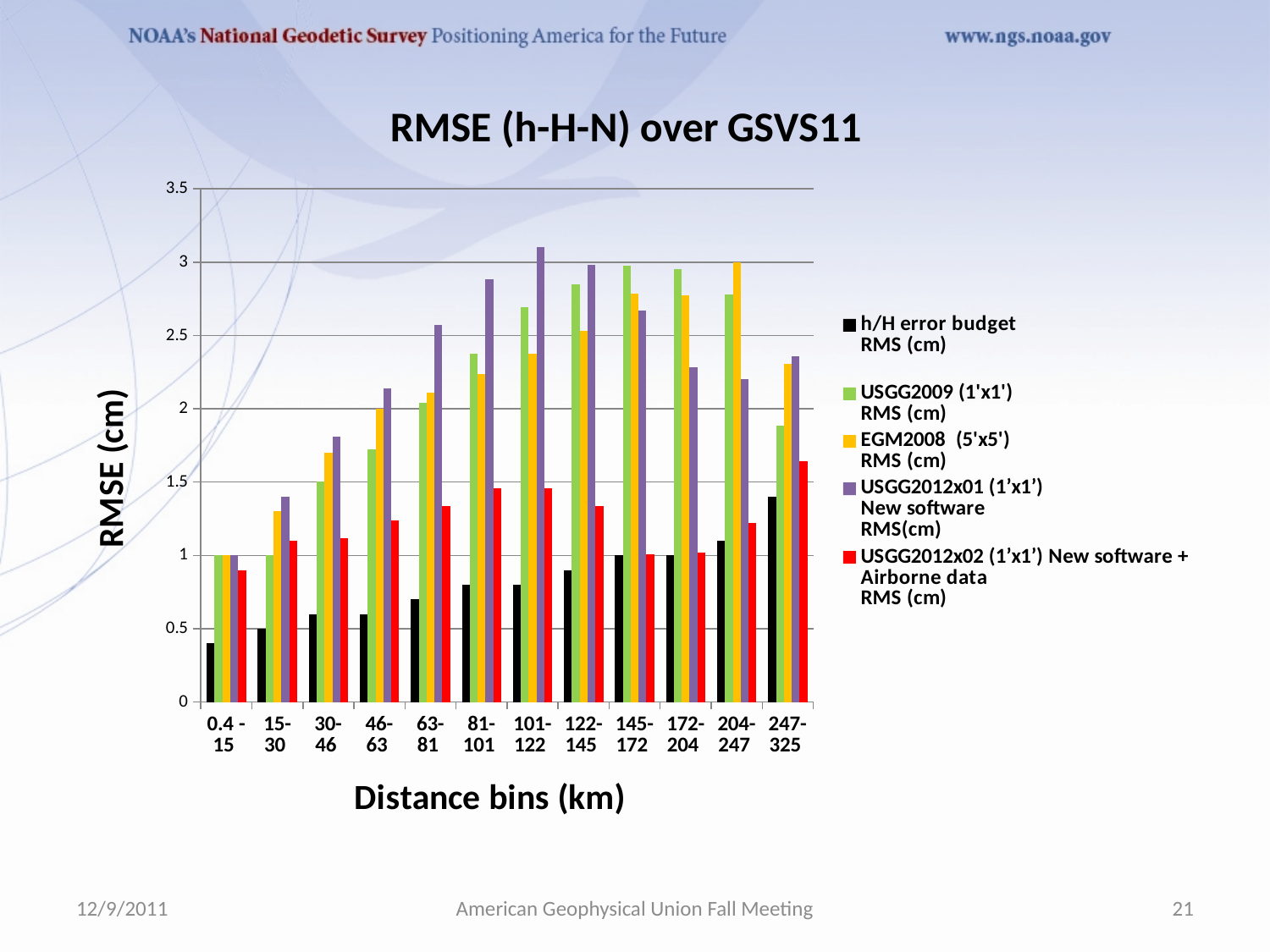
What is the title of the x axis? Distance bins (km) Is the value for USGG2012x01 in the 101-122 km bin greater or less than 2.5? greater Does the h/H error budget series rise or fall as the distance bins increase along the x axis? rise How many distance bins are shown on the x axis? 12 Which series has the highest value in the 101-122 km bin? USGG2012x01 (1'x1') New software RMS(cm) Is the value for h/H error budget in the 0.4-15 km bin greater or less than 0.5? less Which series has the lowest value in the 0.4-15 km bin? h/H error budget RMS (cm) What kind of chart is shown on the slide? bar chart In which distance bin is the h/H error budget highest? 247-325 Is the value for USGG2012x02 in the 247-325 km bin greater or less than 1.5? greater How many series does the legend list? 5 In the 204-247 km bin, which is larger: EGM2008 or USGG2012x01? EGM2008